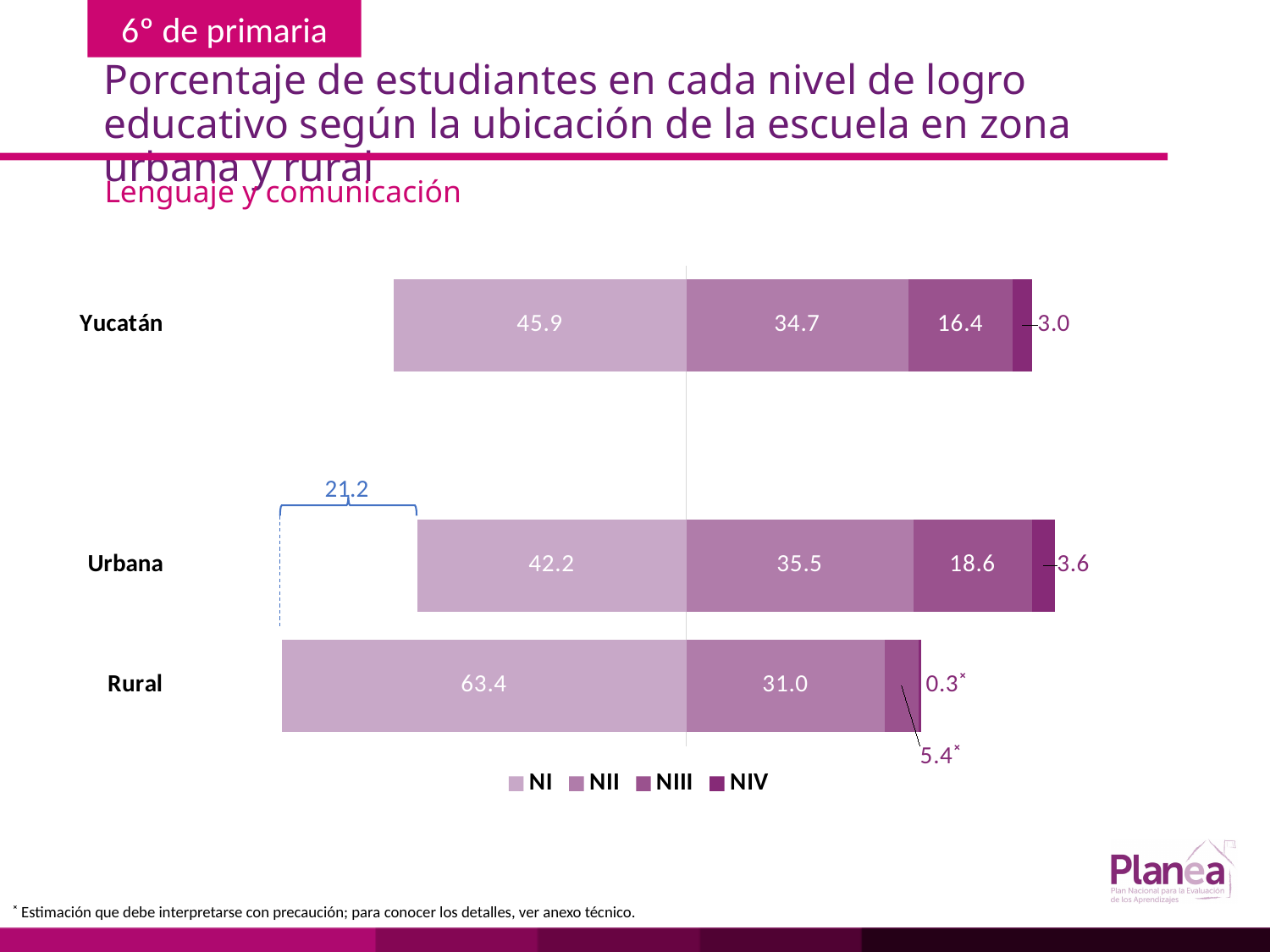
Which series is listed first in the legend? NI What is the NII value for Urbana? 35.5 What is the difference between the NI value for Rural and the NI value for Urbana? 21.2 Which category has the highest NI value? Rural Which category has the lowest NIV value? Rural Which is larger, the NIII value for Urbana or the NIII value for Yucatán? Urbana What type of chart is shown on the slide? Stacked bar chart What is the NI value for Yucatán? 45.9 How many series does the legend list? 4 What is the NIII value for Rural? 5.4 What is the NIV value for Urbana? 3.6 How many categories (bars) are plotted in the chart? 3